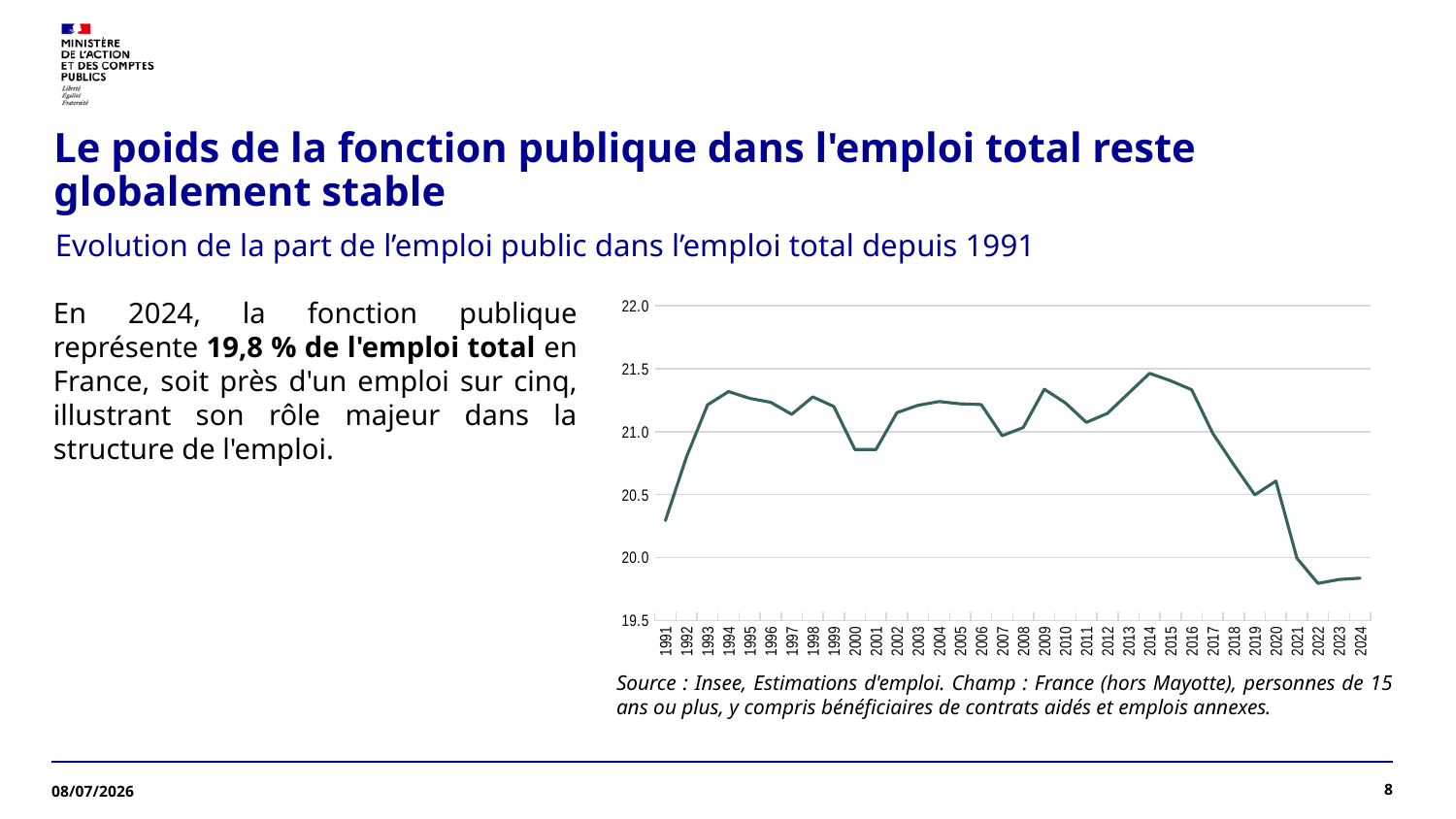
In which year does the line reach its highest value? 2014 What is the first year shown on the x axis of the chart? 1991 How many years (data points) are plotted on the chart, from 1991 to 2024? 34 Which year has the larger value, 2019 or 2021? 2019 Is the value for 2000 greater or less than 21.0? less Is the value for 1991 greater or less than 20.5? less According to the slide, what share of total employment did the public sector represent in 2024? 19,8 % Is the value for 2022 greater or less than 20.0? less Which year has the larger value, 2014 or 2024? 2014 Does the line rise or fall between 2016 and 2022? fall What kind of chart is shown on the slide? Line chart